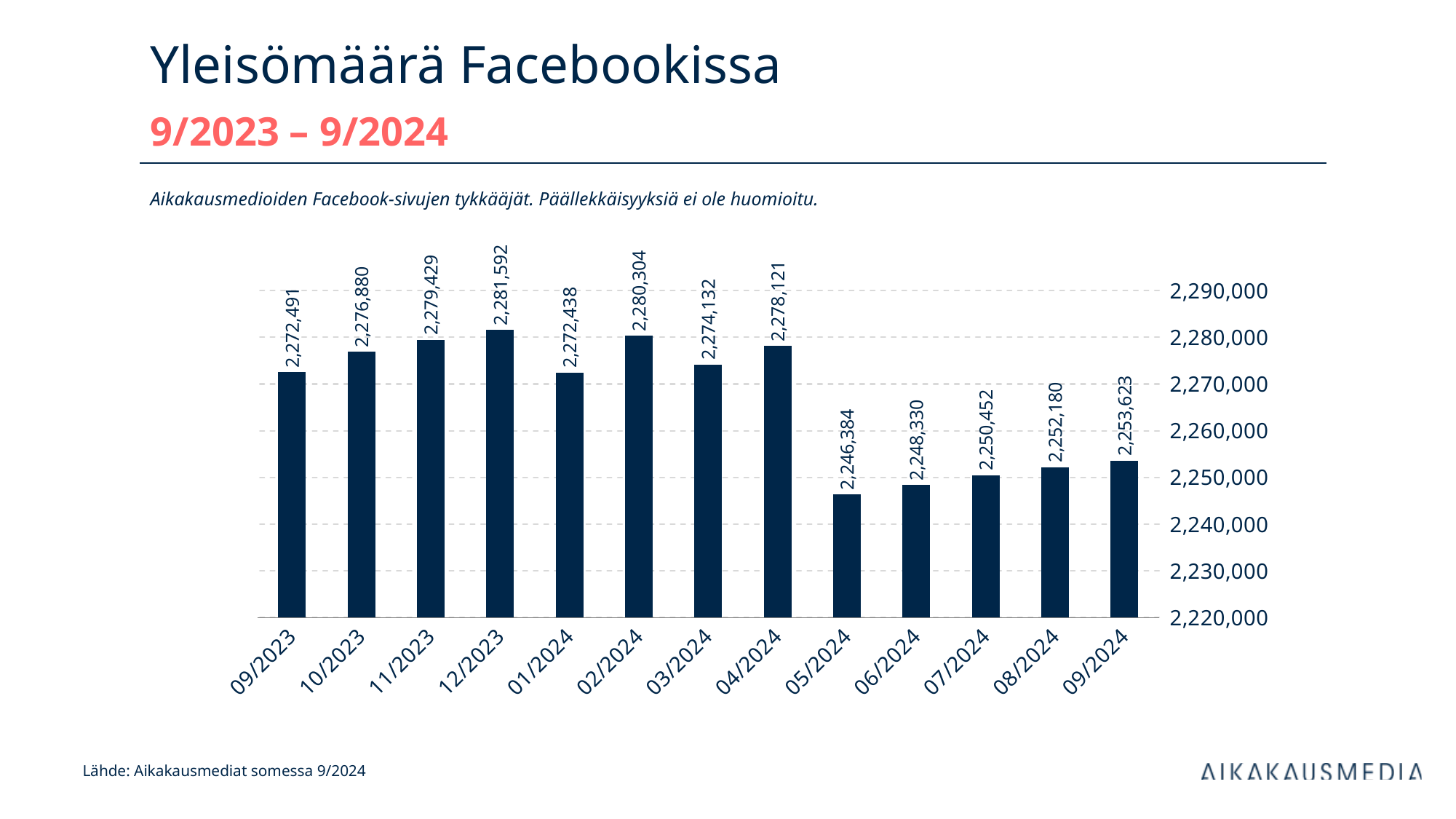
Which is larger, the value for 11/2023 or the value for 03/2024? 11/2023 Is the value for 05/2024 greater or less than 2,250,000? less What is the difference between the values for 12/2023 and 05/2024? 35,208 How many months are shown on the x axis? 13 What kind of chart is shown on the slide? bar chart Which month has the lowest value? 05/2024 Which month has the highest value? 12/2023 What is the value for 09/2024? 2,253,623 What is the value for 05/2024? 2,246,384 Do the values rise or fall from 05/2024 to 09/2024? rise What is the difference between the values for 09/2023 and 09/2024? 18,868 What is the value for 12/2023? 2,281,592